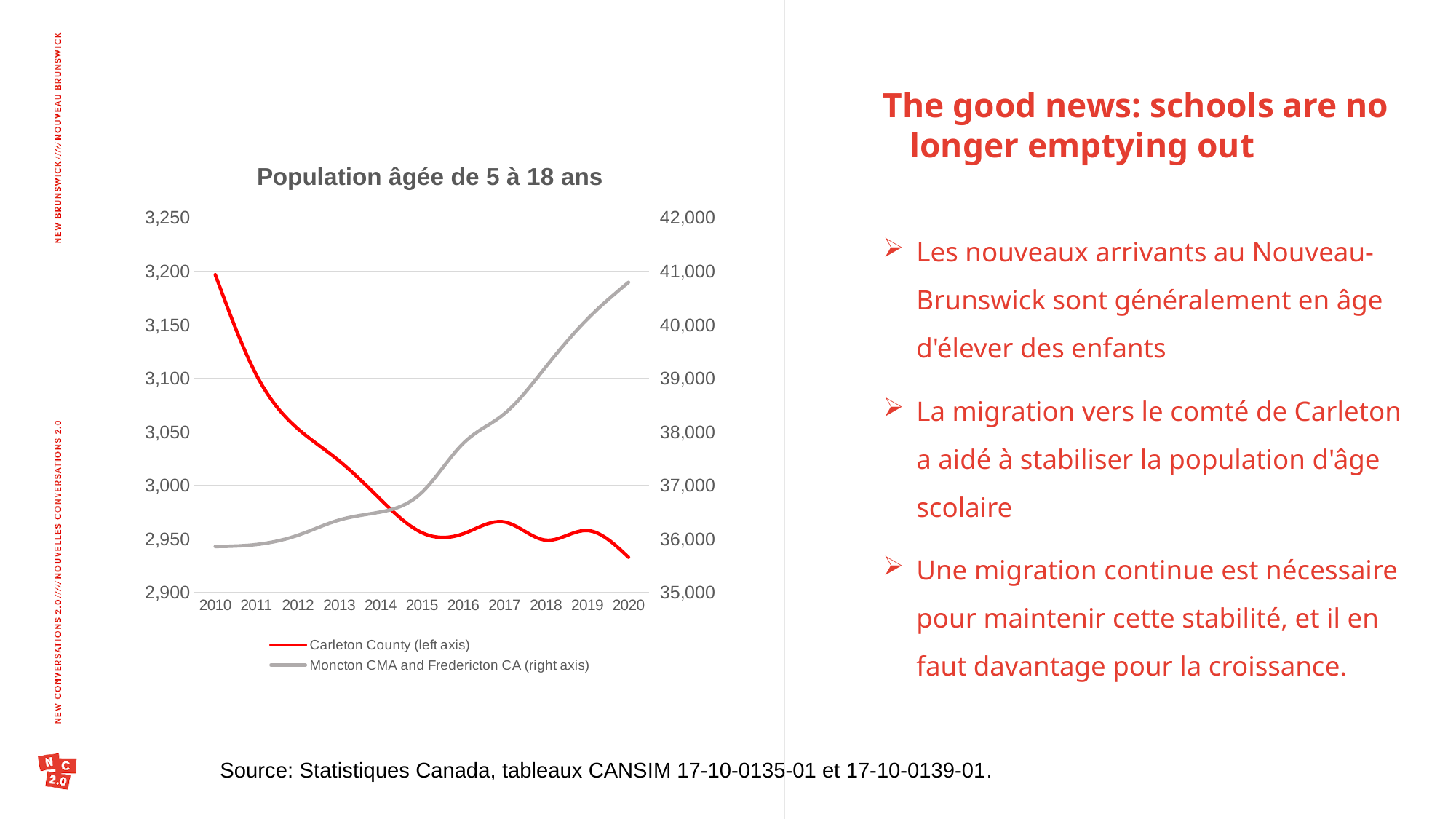
How many years are plotted along the x axis of the chart? 11 Does the Carleton County line generally rise or fall from 2010 to 2020? fall What kind of chart is shown on the slide? line chart Is the Moncton CMA and Fredericton CA value for 2020 greater or less than 40,000? greater How many series does the chart's legend list? 2 Which series is plotted against the right axis? Moncton CMA and Fredericton CA What is the title of the chart? Population âgée de 5 à 18 ans Is the Carleton County value for 2010 greater or less than 3,150? greater In which year is the Carleton County value highest? 2010 Does the Moncton CMA and Fredericton CA line rise or fall from 2010 to 2020? rise Is the Carleton County value for 2020 greater or less than 3,000? less In which year is the Moncton CMA and Fredericton CA value highest? 2020